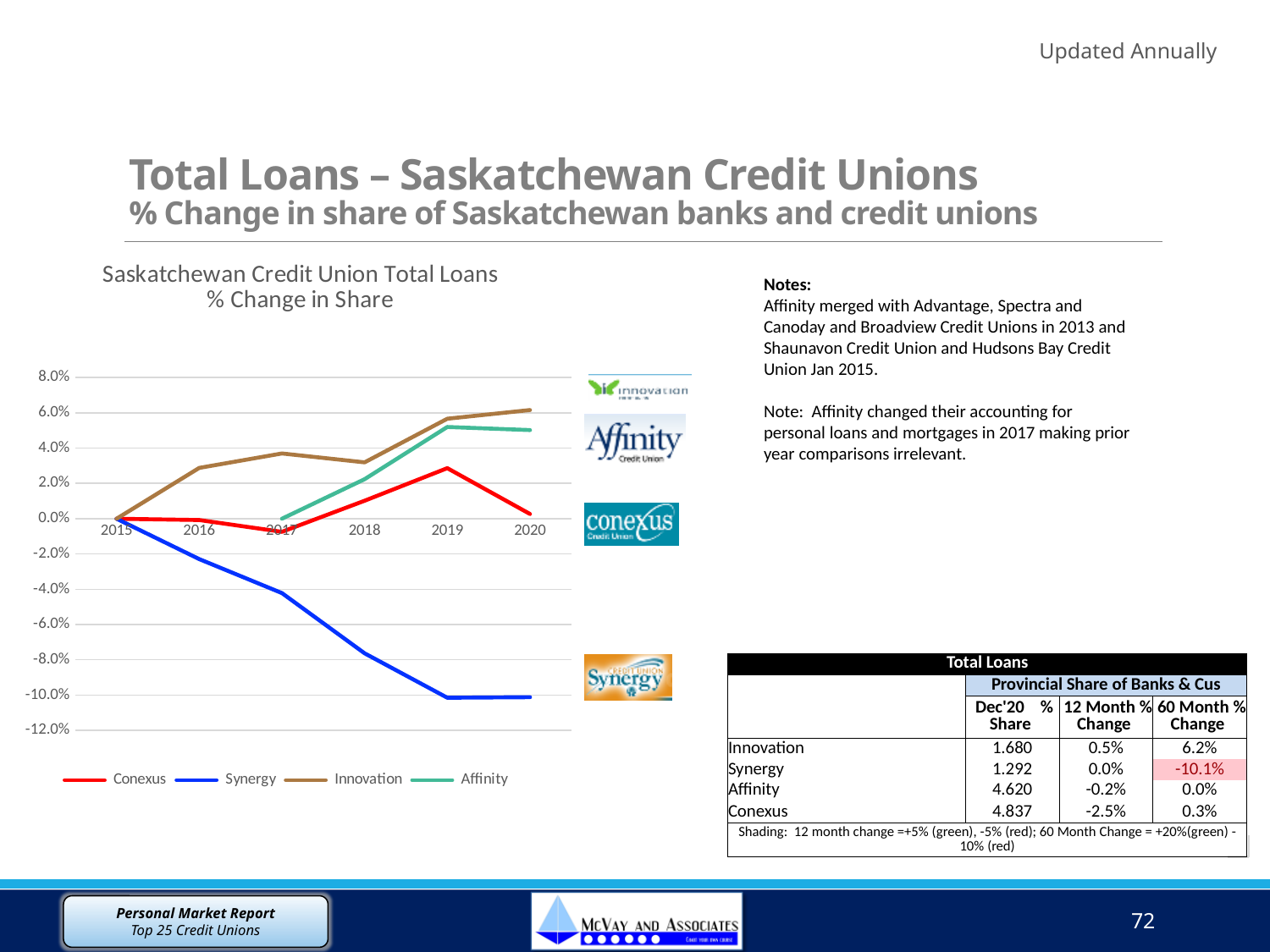
Is the value for Affinity in 2019 greater or less than 4.0%? greater Is the value for Synergy in 2020 greater or less than -8.0%? less Does the Synergy line rise or fall from 2015 to 2019? fall Is the value for Innovation in 2020 greater or less than 4.0%? greater In 2019, which is higher: Innovation or Conexus? Innovation What kind of chart is shown on the slide? line chart Which series has the highest value in 2020? Innovation What is the title of the chart? Saskatchewan Credit Union Total Loans % Change in Share How many series does the chart legend list? 4 Which series has the lowest value in 2020? Synergy How many years are shown along the x axis of the chart? 6